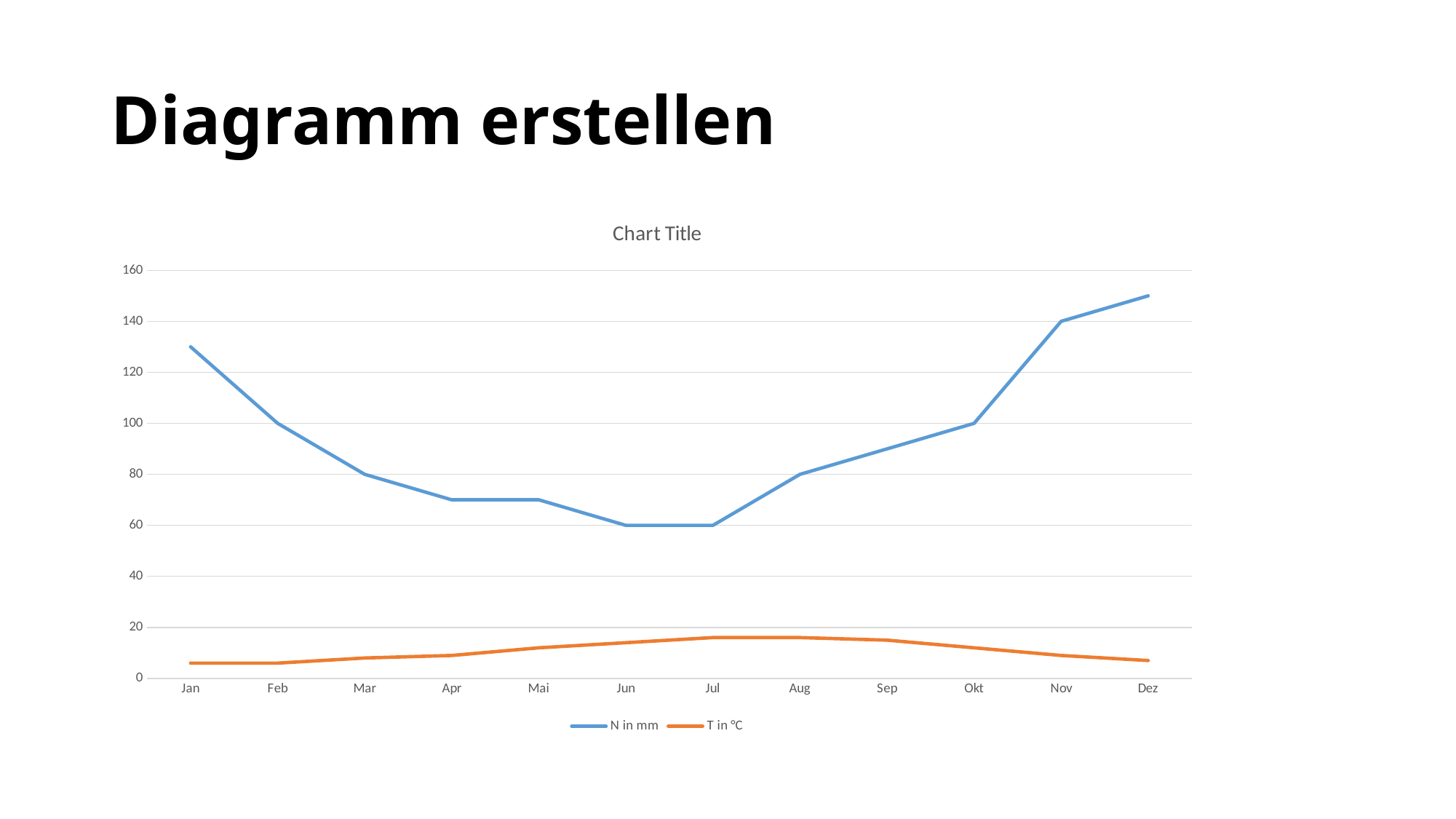
What kind of chart is shown on the slide? line chart What is the value of N in mm for Jun? 60 What is the difference between N in mm for Nov and N in mm for Okt? 40 Does N in mm rise or fall from Jan to Jun? fall Is the value of N in mm for Jan greater or less than 120? greater Is the value of T in °C for Jul greater or less than 20? less In which month is N in mm highest? Dez What is the value of N in mm for Nov? 140 Which is larger, N in mm for Jan or N in mm for Feb? Jan What is the value of N in mm for Feb? 100 How many series does the legend list? 2 How many months are shown on the x axis? 12